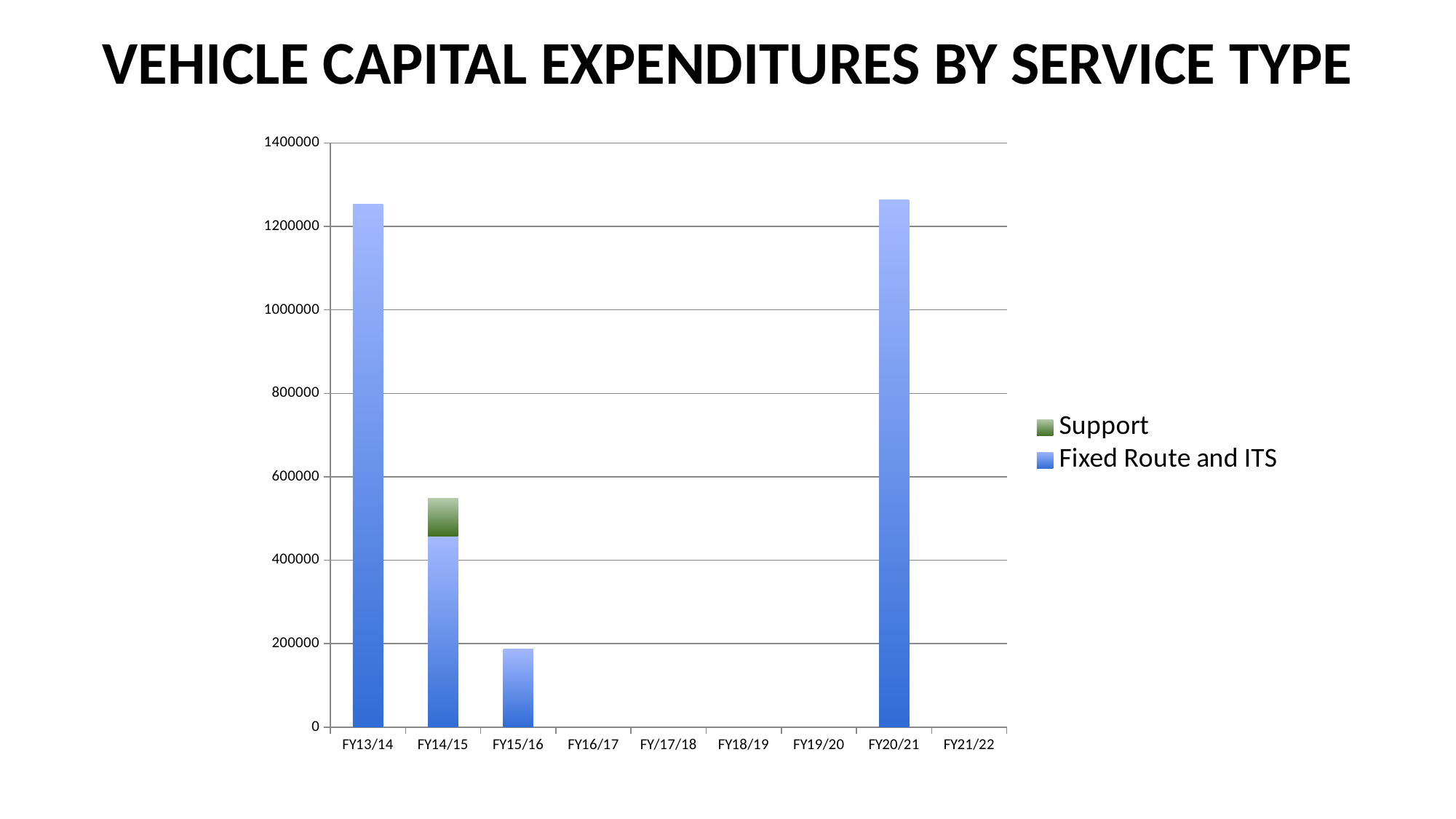
Which is larger, the total for FY14/15 or the total for FY15/16? FY14/15 Which series is shown in green in the legend? Support How many series does the legend list? 2 Is the Fixed Route and ITS value for FY14/15 greater or less than 400000? greater Is the value for FY13/14 greater or less than 1200000? greater Is the value for FY20/21 greater or less than 1200000? greater Which fiscal year is the only one with a Support segment in its bar? FY14/15 What is the title of the chart? VEHICLE CAPITAL EXPENDITURES BY SERVICE TYPE What kind of chart is shown on the slide? Bar chart How many fiscal year categories are shown on the x axis? 9